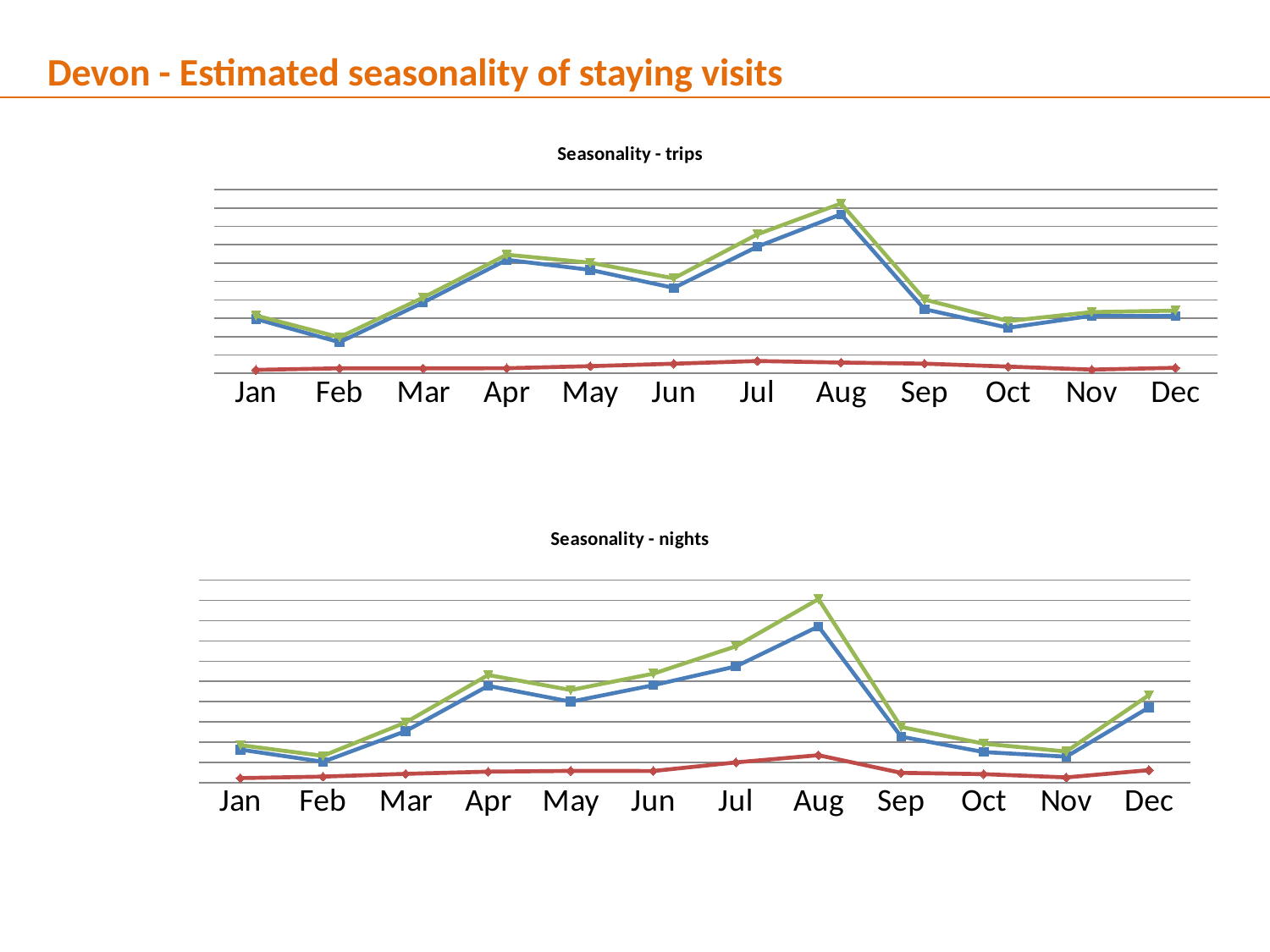
In 'Seasonality - nights', which month has the highest value for the red line? Aug How many lines are plotted in 'Seasonality - nights'? 3 In 'Seasonality - nights', does the green line rise or fall from Aug to Sep? fall What is the title of the top chart on the slide? Seasonality - trips In 'Seasonality - nights', is the blue line higher in Nov or in Dec? Dec In 'Seasonality - trips', which month has the lowest value for the blue line? Feb How many months are shown on the x axis of 'Seasonality - nights'? 12 In 'Seasonality - nights', which month has the lowest value for the blue line? Feb In 'Seasonality - nights', which month has the highest value for the green line? Aug In 'Seasonality - trips', which month has the highest value for the green line? Aug In 'Seasonality - trips', is the green line higher in Apr or in Jun? Apr What kind of chart is 'Seasonality - trips'? line chart